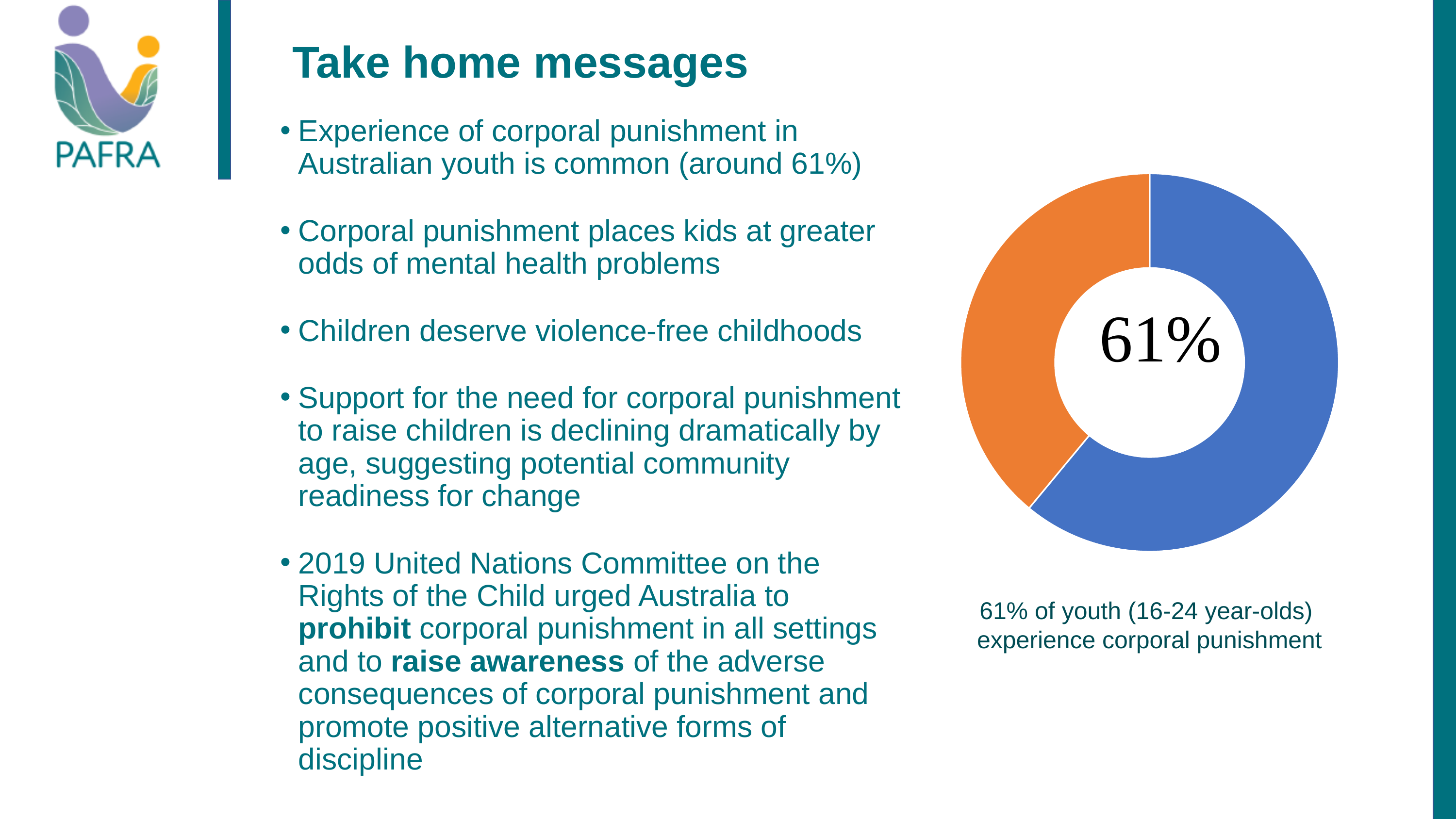
What age group does the chart caption say the 61% figure refers to? 16-24 year-olds According to the chart caption, what share of youth (16-24 year-olds) experience corporal punishment? 61% What share of the donut chart does the orange slice represent? 39% What kind of chart is shown on the right of the slide? Donut (pie) chart What percentage is printed in the centre of the donut chart? 61% Does the donut chart include a legend? No Which colour represents the largest slice of the donut chart? Blue How many slices does the donut chart have? 2 Which colour represents the smallest slice of the donut chart? Orange Which slice of the donut chart is larger, the blue one or the orange one? Blue